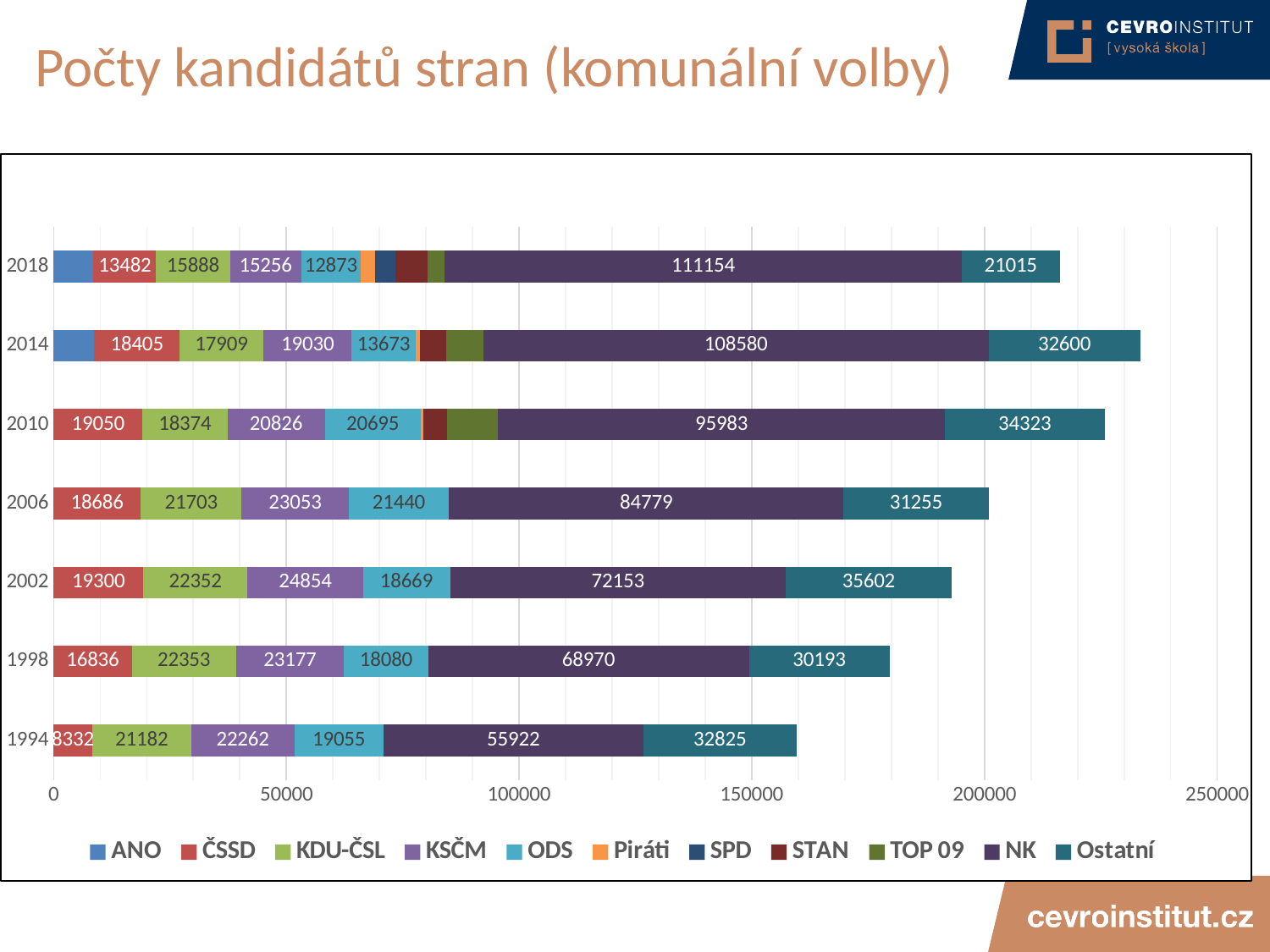
What is the value for ODS in 1994? 19055 How many series does the legend list? 11 What is the difference between the NK value in 2018 and in 2014? 2574 Is the total length of the 2014 bar greater or less than 200000? greater What kind of chart is shown on the slide? stacked bar chart In 2002, which is larger: the value for KSČM or for KDU-ČSL? KSČM Do the NK values rise or fall from 1994 to 2018? rise What is the value for NK in 2018? 111154 In which year is the NK value the highest? 2018 In which year is the ČSSD value the lowest? 1994 How many election years are shown on the y axis? 7